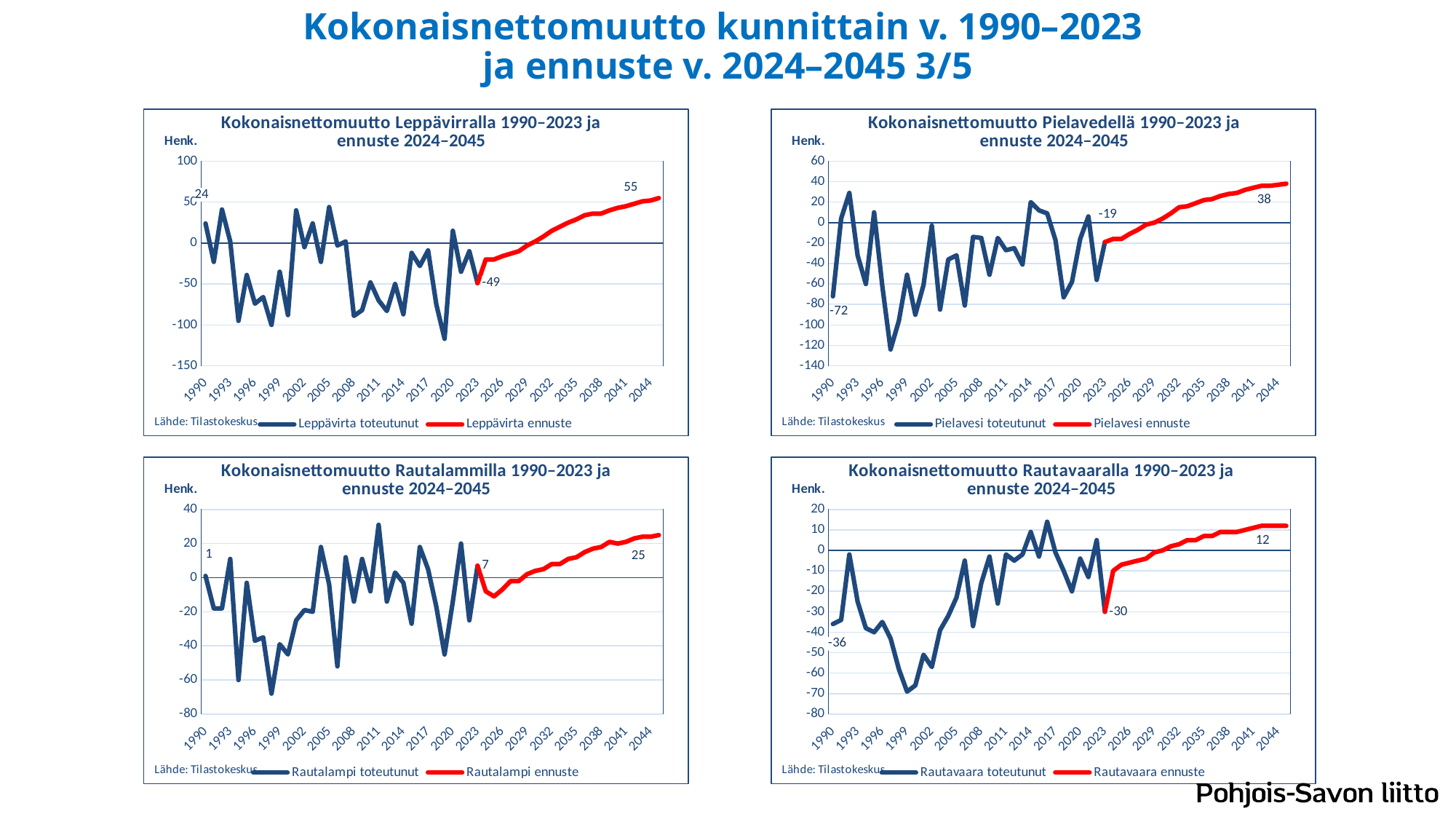
On the Rautavaara chart, what is the difference between the 2045 forecast value (12) and the 2023 value (-30)? 42 On the Rautalampi chart, what is the labelled value for 2023? 7 On the Rautalampi chart, which is larger: the 1990 value or the 2045 forecast value? 2045 forecast value On the Rautavaara chart, what is the labelled value for 1990? -36 On the Pielavesi chart, what is the labelled forecast value for 2045? 38 How many series does the legend of the Leppävirta chart list? 2 On the Leppävirta chart, what is the labelled value for 2023? -49 What kind of chart is the Rautavaara chart? Line chart On the Leppävirta chart, what is the labelled value for 1990? 24 On the Pielavesi chart, what is the difference between the 2045 forecast value (38) and the 2023 value (-19)? 57 On the Leppävirta chart, what is the forecast value labelled at the end of the series in 2045? 55 On the Pielavesi chart, what is the labelled value for 1990? -72